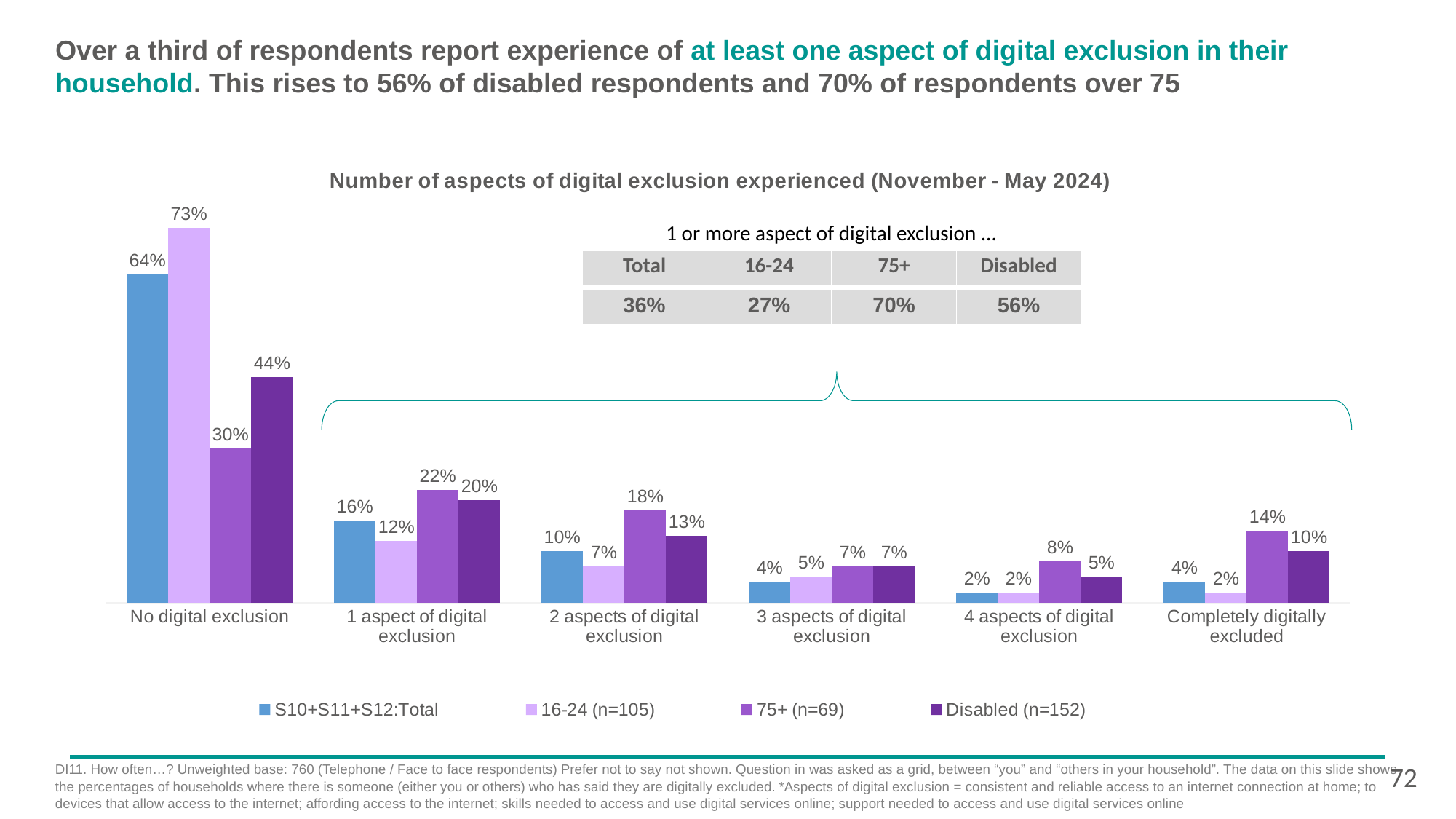
Which series has the lowest value in the 'No digital exclusion' category? 75+ (n=69) According to the table on the chart, what percentage of 75+ respondents report 1 or more aspect of digital exclusion? 70% What is the title of the chart? Number of aspects of digital exclusion experienced (November - May 2024) What is the value for the 16-24 (n=105) series in the 'No digital exclusion' category? 73% What is the value for the Disabled (n=152) series in the '2 aspects of digital exclusion' category? 13% What is the value for the 75+ (n=69) series in the 'Completely digitally excluded' category? 14% Which series has the highest value in the 'No digital exclusion' category? 16-24 (n=105) Which is larger in the '1 aspect of digital exclusion' category: the S10+S11+S12:Total value or the 75+ (n=69) value? 75+ (n=69) How many categories are shown on the x axis of the chart? 6 What is the difference between the 16-24 (n=105) and 75+ (n=69) values in the 'No digital exclusion' category? 43% How many series does the legend list? 4 What kind of chart is shown on the slide? Bar chart